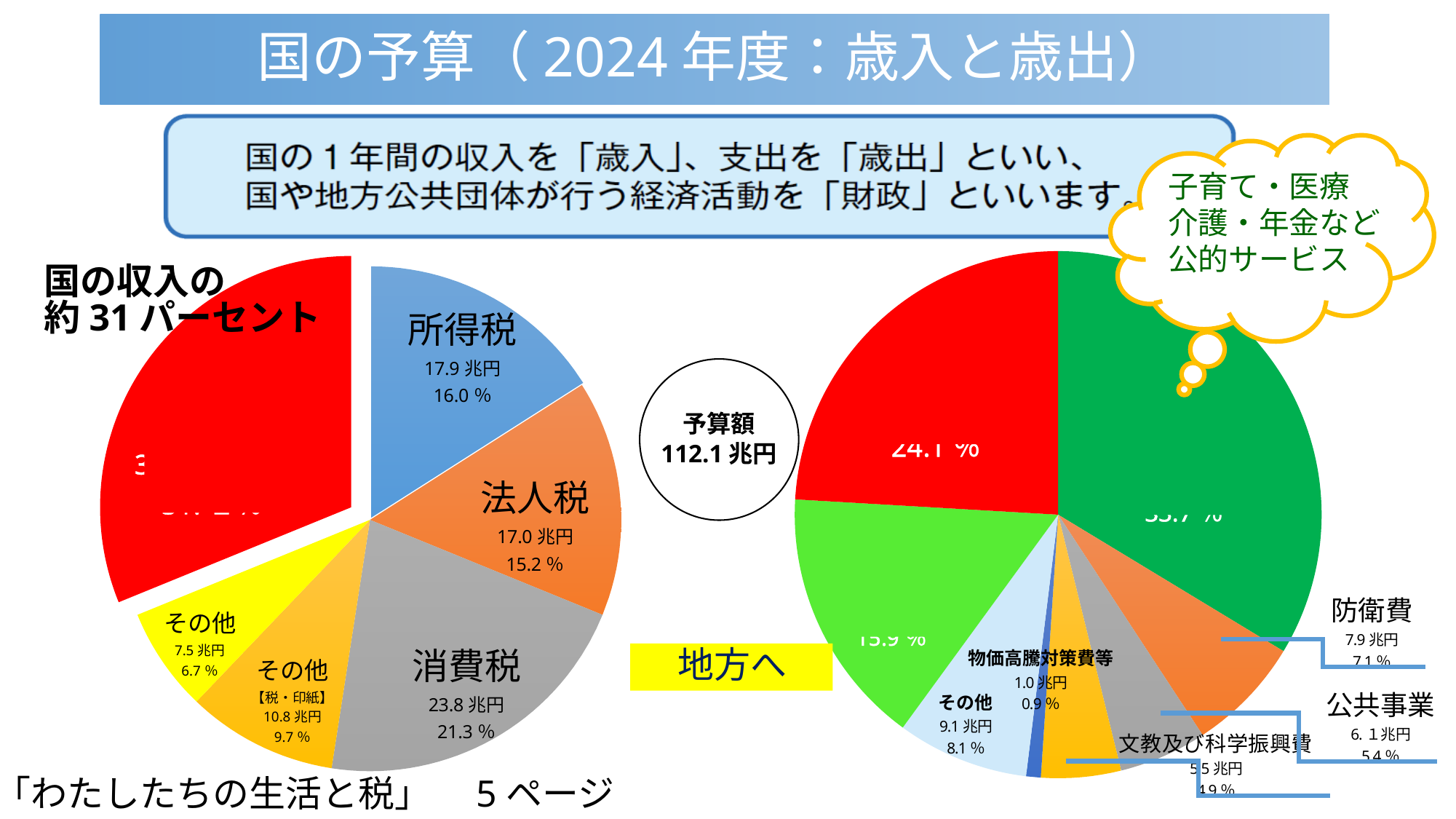
In the right pie chart (歳出), what is the value shown for 防衛費? 7.9 兆円 In the left pie chart (国の収入), what percentage is shown for 所得税? 16.0 % In the left pie chart (国の収入), what is the value shown for 法人税? 17.0 兆円 In the left pie chart (国の収入), what is the difference in 兆円 between 消費税 and 所得税? 5.9 兆円 In the right pie chart (歳出), what percentage is shown for 公共事業? 5.4 % In the right pie chart (歳出), what percentage is shown for 物価高騰対策費等? 0.9 % In the left pie chart (国の収入), which is larger, 所得税 or 法人税? 所得税 In the right pie chart (歳出), what is the value shown for 文教及び科学振興費? 5.5 兆円 What kind of chart is the chart on the left of the slide? pie chart In the left pie chart (国の収入), what is the value shown for 消費税? 23.8 兆円 In the right pie chart (歳出), which is larger, 防衛費 or 公共事業? 防衛費 In the left pie chart (国の収入), what is the value shown for その他【税・印紙】? 10.8 兆円